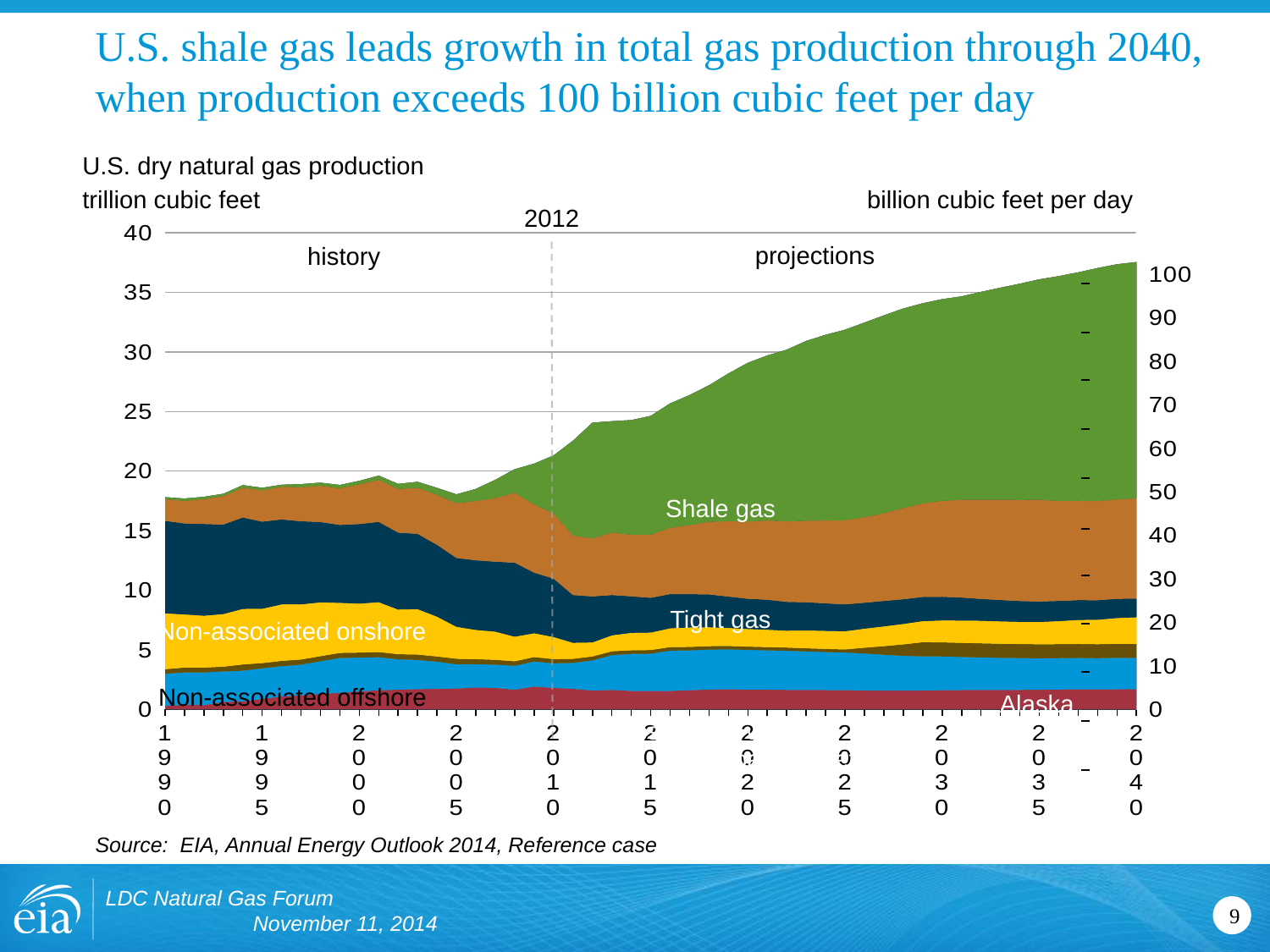
Is non-associated onshore production larger in 1990 or in 2040? 1990 How many production categories are labeled directly on the chart? 5 How many year labels are shown along the x axis? 11 What unit is shown on the left vertical axis of the chart? trillion cubic feet What kind of chart is shown on the slide? Stacked area chart What is the title of the chart? U.S. dry natural gas production Does total U.S. dry natural gas production rise or fall over the projection period from 2012 to 2040? Rise Which year does the dashed vertical line separating history from projections mark? 2012 Is total dry natural gas production in 2040 greater or less than 35 trillion cubic feet? greater Is shale gas production in 2040 greater or less than 10 trillion cubic feet? greater Which production category is the largest in 2040? Shale gas Is total dry natural gas production in 1990 greater or less than 20 trillion cubic feet? less